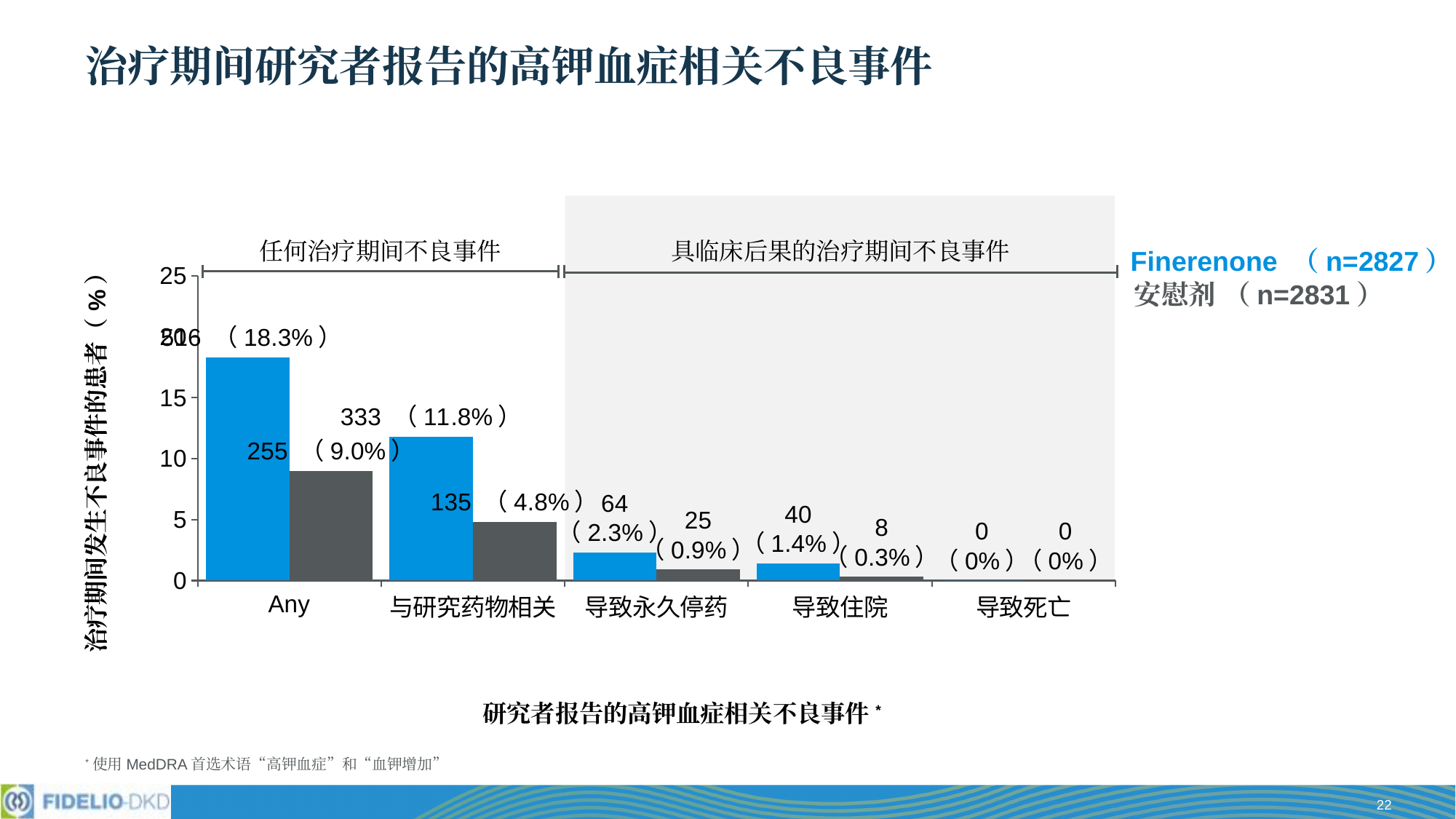
Which group has the larger percentage of adverse events related to study drug (与研究药物相关), Finerenone or placebo? Finerenone How many categories are shown on the x axis? 5 What is the difference in percentage points between Finerenone and placebo for the Any category? 9.3 What percentage of Finerenone patients had any treatment-emergent hyperkalaemia adverse event (Any)? 18.3% What percentage of Finerenone patients had a hyperkalaemia adverse event leading to hospitalisation (导致住院)? 1.4% What type of chart is shown on the slide? Bar chart How many series does the chart show? 2 How many Finerenone patients had a hyperkalaemia adverse event related to study drug (与研究药物相关)? 333 What percentage of placebo (安慰剂) patients had any treatment-emergent hyperkalaemia adverse event (Any)? 9.0% Which category has the highest percentage for Finerenone? Any How many patients in each group had a hyperkalaemia adverse event leading to death (导致死亡)? 0 How many placebo (安慰剂) patients had a hyperkalaemia adverse event leading to permanent discontinuation (导致永久停药)? 25